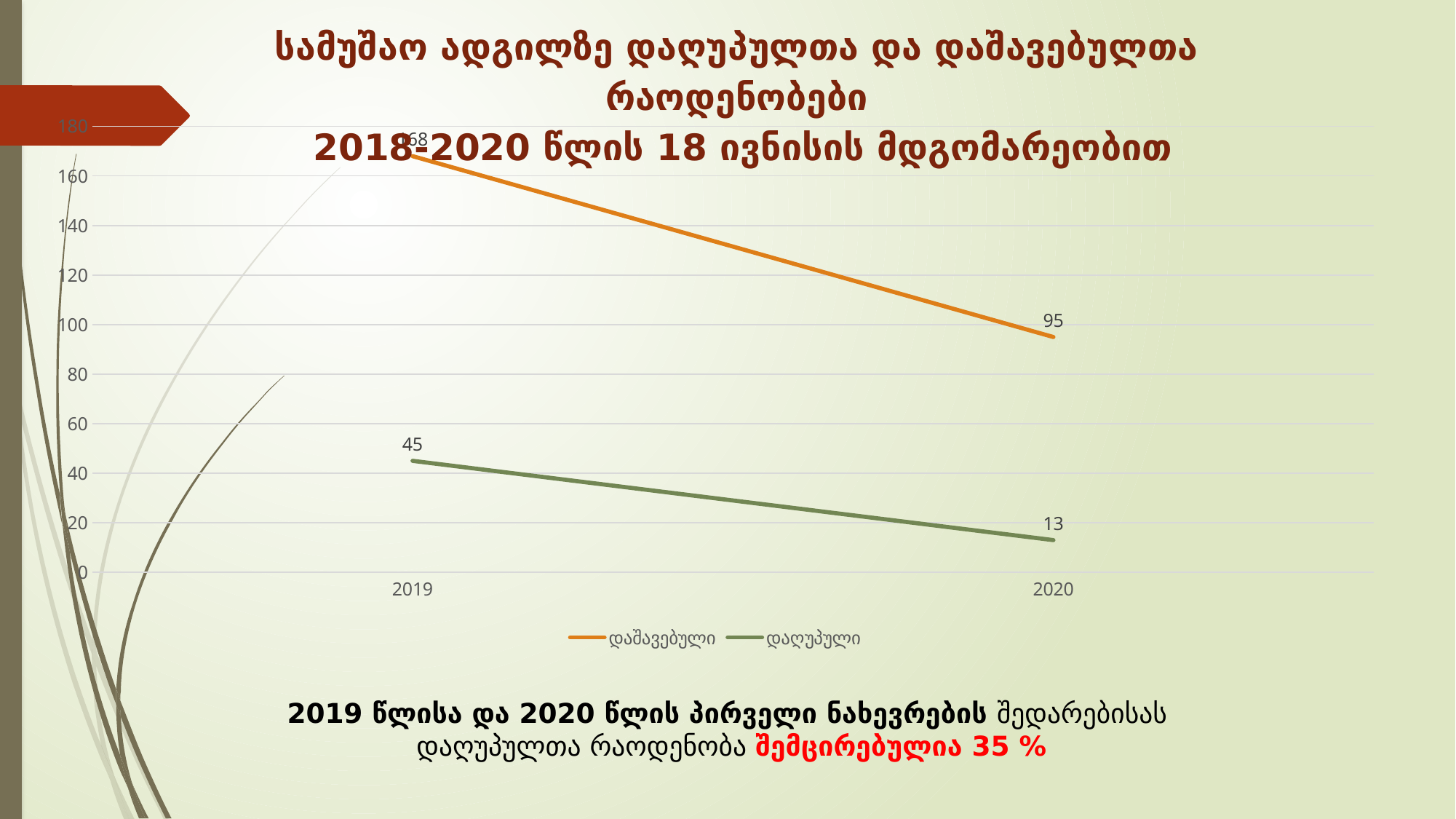
What is the value for დაღუპული in 2019? 45 How many years are shown on the x axis? 2 Is the value for დაშავებული in 2019 greater or less than 160? greater What kind of chart is shown on the slide? line chart By how much did the value for დაღუპული decrease from 2019 to 2020? 32 Does the დაშავებული line rise or fall from 2019 to 2020? fall In 2020, which series has the larger value, დაშავებული or დაღუპული? დაშავებული What is the difference between დაშავებული and დაღუპული in 2020? 82 Does the დაღუპული line rise or fall from 2019 to 2020? fall What is the value for დაღუპული in 2020? 13 How many series does the legend list? 2 What is the value for დაშავებული in 2020? 95